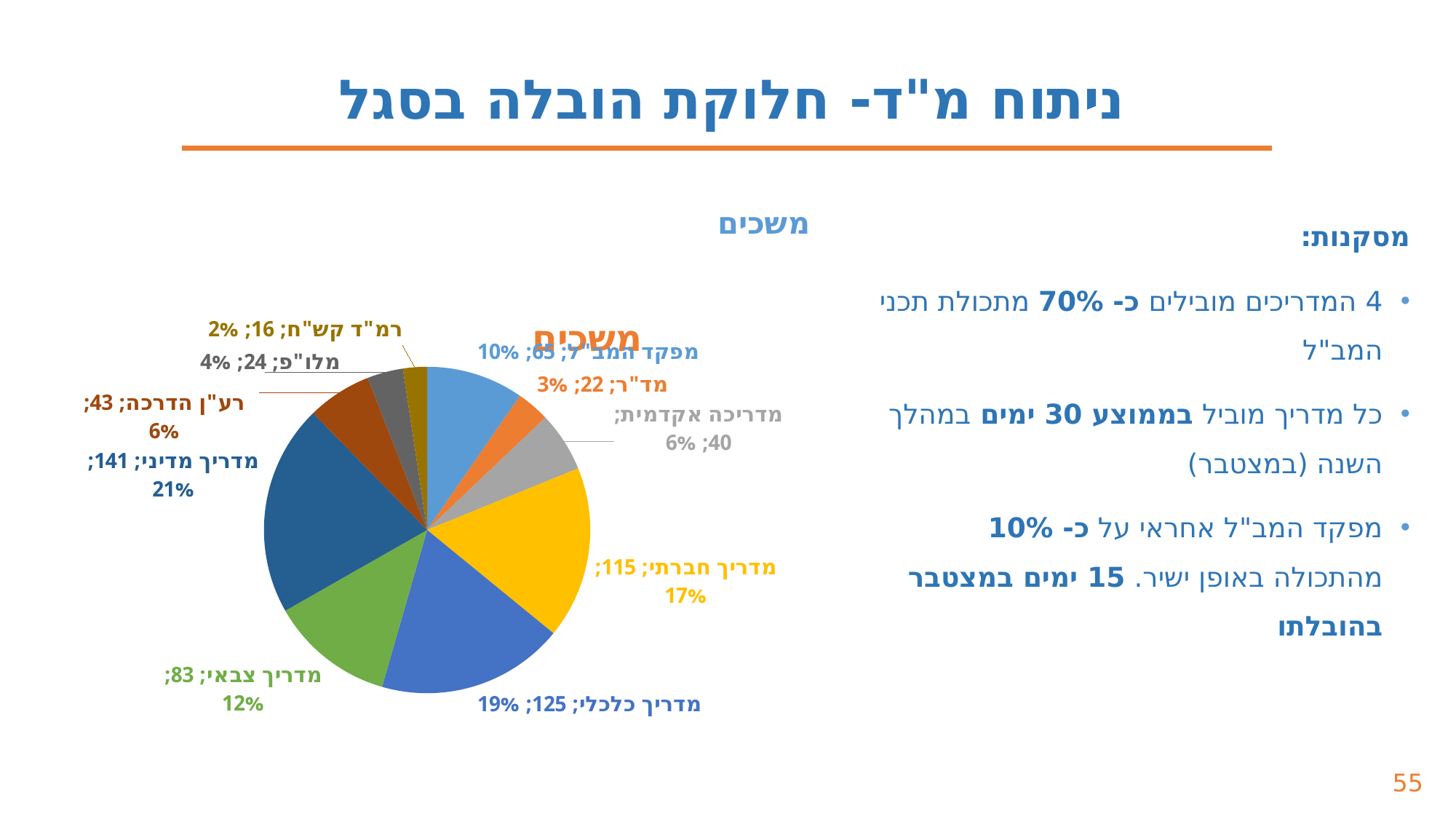
What is the value for מדריך מדיני in the pie chart? 141 What is the value for מלו"פ in the pie chart? 24 What kind of chart is shown on the slide? pie chart What share of the pie does מדריכה אקדמית represent? 6% How many slices does the pie chart have? 10 What share of the pie does מדריך כלכלי represent? 19% Which category has the largest slice in the pie chart? מדריך מדיני Which is larger, the value for מדריך צבאי or the value for רע"ן הדרכה? מדריך צבאי What is the value for מפקד המב"ל in the pie chart? 65 Which category has the smallest slice in the pie chart? רמ"ד קש"ח What is the difference between the values for מדריך כלכלי and מדריך חברתי? 10 What is the title of the pie chart? משכים